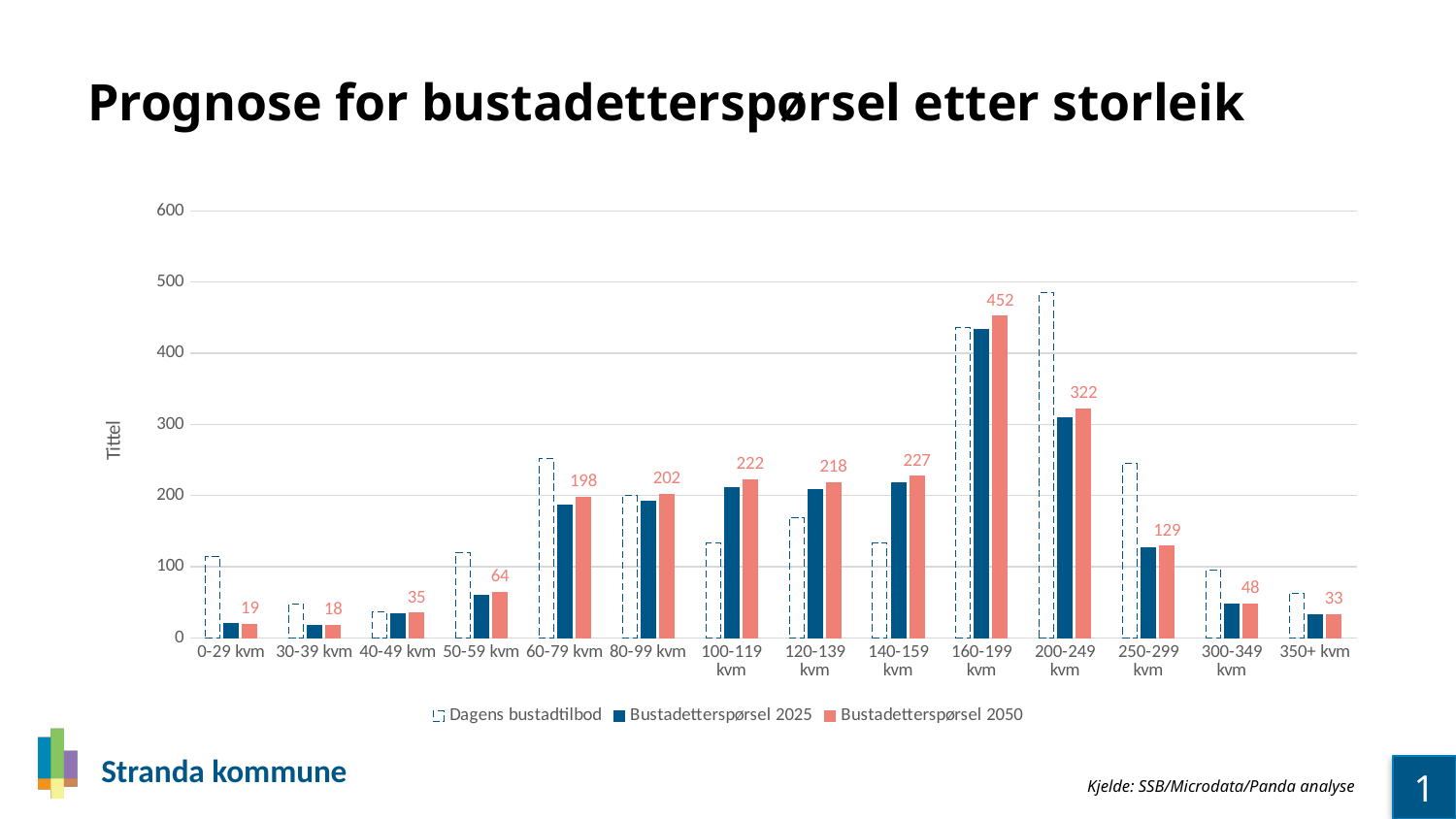
Is the value for Dagens bustadtilbod in the 200-249 kvm category greater or less than 400? greater What is the value for Bustadetterspørsel 2050 in the 250-299 kvm category? 129 What is the value for Bustadetterspørsel 2050 in the 160-199 kvm category? 452 What kind of chart is shown on the slide? Bar chart How many size categories are shown on the x axis? 14 Which is larger for Bustadetterspørsel 2050: 140-159 kvm or 120-139 kvm? 140-159 kvm What is the value for Bustadetterspørsel 2050 in the 50-59 kvm category? 64 What is the difference between the Bustadetterspørsel 2050 values for 160-199 kvm and 200-249 kvm? 130 Which category has the highest value for Bustadetterspørsel 2050? 160-199 kvm Which category has the lowest value for Bustadetterspørsel 2050? 30-39 kvm Is the value for Bustadetterspørsel 2025 in the 60-79 kvm category greater or less than 200? less How many series does the legend list? 3